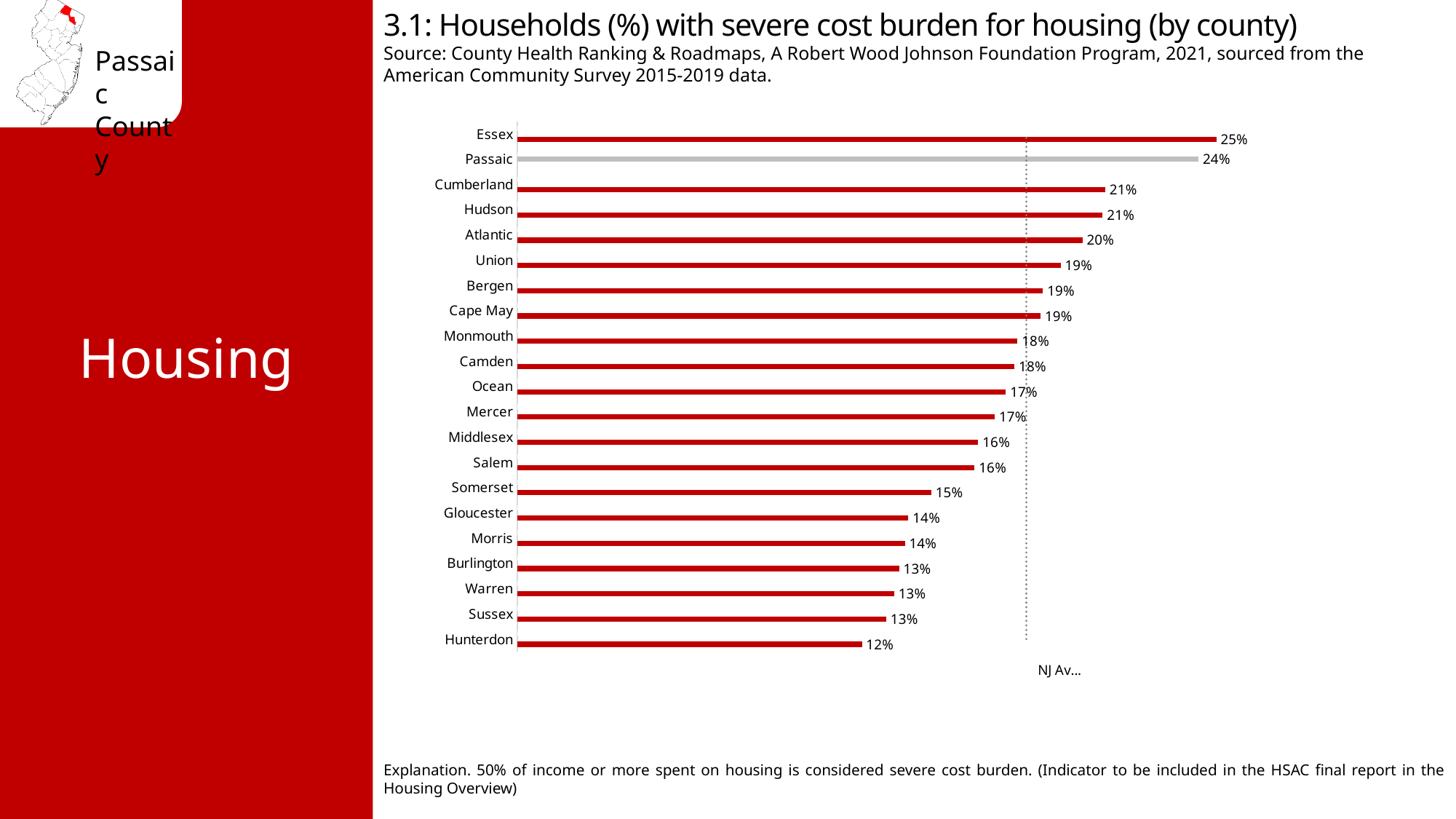
What is the value for Somerset? 15% Which county has the lowest value? Hunterdon Which county has the highest value? Essex What kind of chart is this? Bar chart Which county's bar is shown in grey rather than red? Passaic What is the value for Passaic? 24% How many counties are shown in the chart? 21 Which is larger, the value for Morris or the value for Union? Union What is the difference between the values for Passaic and Atlantic? 4% What is the difference between the values for Essex and Hunterdon? 13% Which is larger, the value for Cumberland or the value for Middlesex? Cumberland What is the value for Hudson? 21%